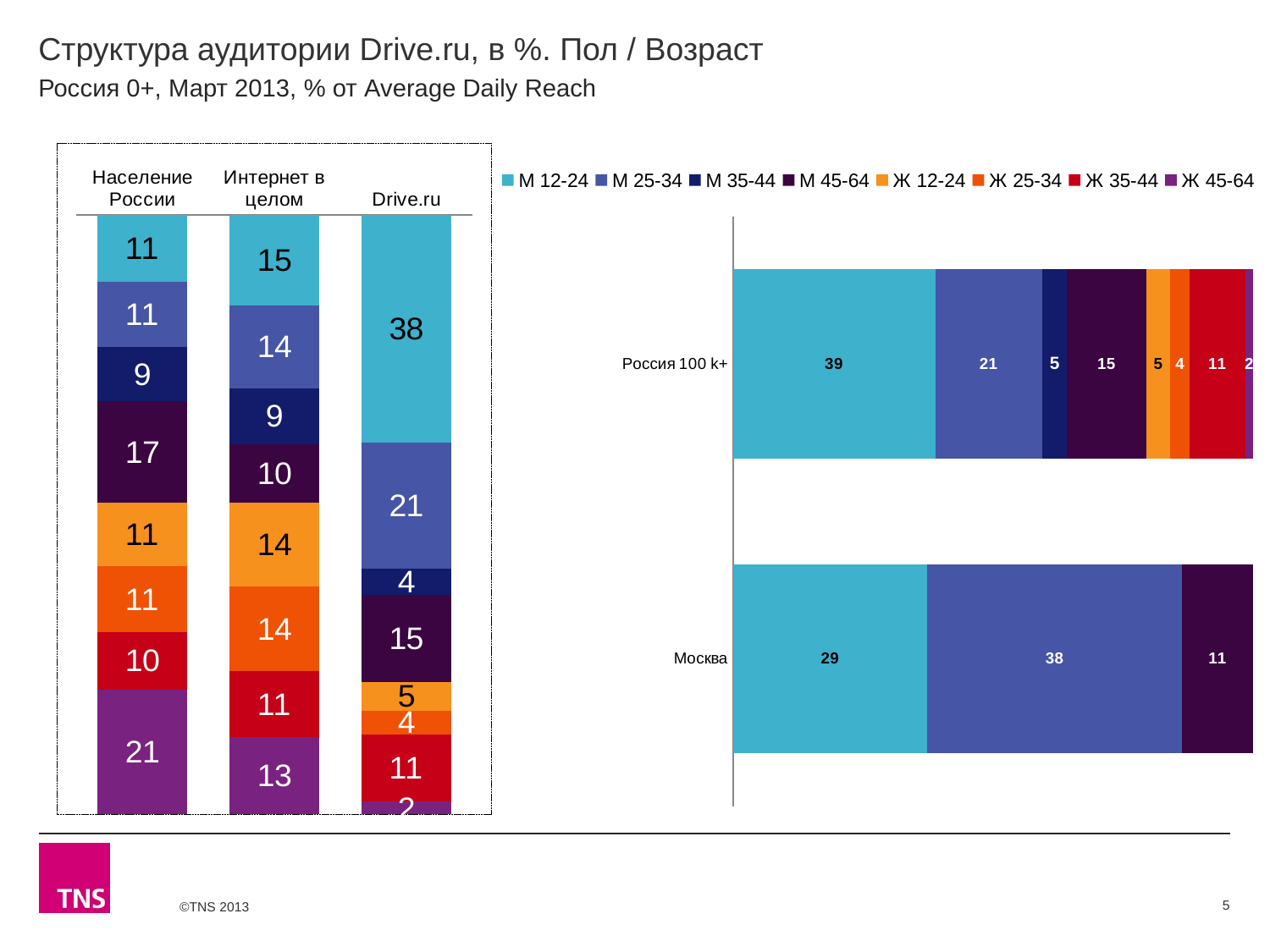
In the left chart, which segment of the Drive.ru bar is the largest? М 12-24 In the left chart, what is the value of the М 45-64 segment for Интернет в целом? 10 In the left chart, what is the value of the М 12-24 segment for Drive.ru? 38 How many bars does the left chart contain? 3 In the left chart, what is the difference between the М 12-24 values for Drive.ru and Население России? 27 What type of chart is the right chart? Stacked bar chart In the right chart, which is larger: the М 12-24 segment for Россия 100 k+ or for Москва? Россия 100 k+ How many series does the legend on the right list? 8 In the left chart, which segment of the Drive.ru bar is the smallest? Ж 45-64 In the right chart, what is the value of the М 25-34 segment for Москва? 38 In the right chart, what is the value of the Ж 35-44 segment for Россия 100 k+? 11 In the left chart, what is the value of the Ж 45-64 segment for Население России? 21